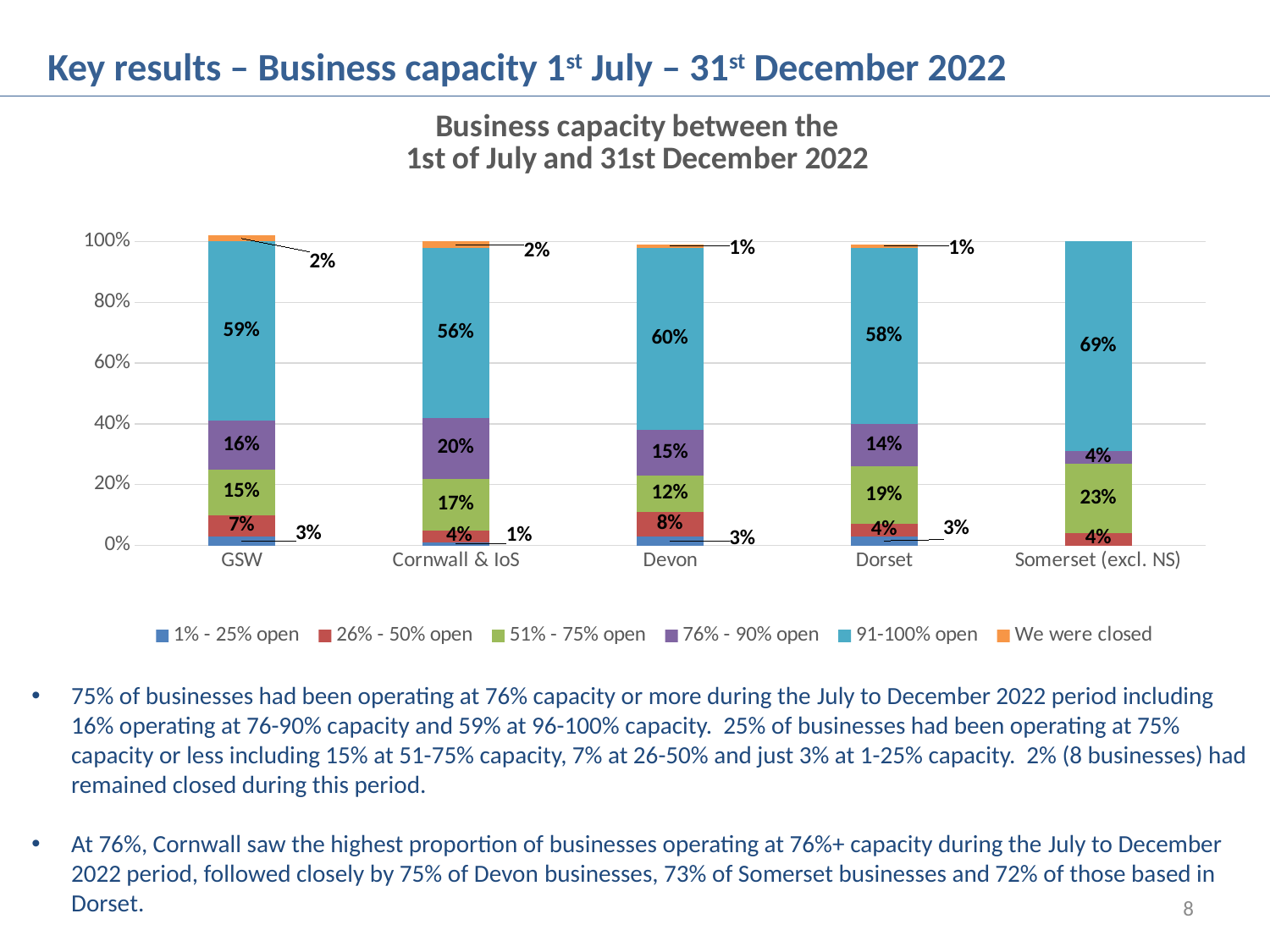
Which region has the highest share of businesses operating at 91-100% open? Somerset (excl. NS) What percentage of GSW businesses were operating at 91-100% open? 59% Which is larger: the 51% - 75% open share for Dorset or for Devon? Dorset What percentage of Cornwall & IoS businesses were operating at 76% - 90% open? 20% What kind of chart is shown on the slide? Stacked bar chart What is the difference between the 91-100% open share for Somerset (excl. NS) and for Cornwall & IoS? 13 percentage points How many regions are shown on the x axis? 5 What is the title of the chart? Business capacity between the 1st of July and 31st December 2022 What percentage of Devon businesses were operating at 26% - 50% open? 8% How many series does the legend list? 6 What percentage of Somerset (excl. NS) businesses were operating at 51% - 75% open? 23% Which region has the lowest share of businesses operating at 91-100% open? Cornwall & IoS